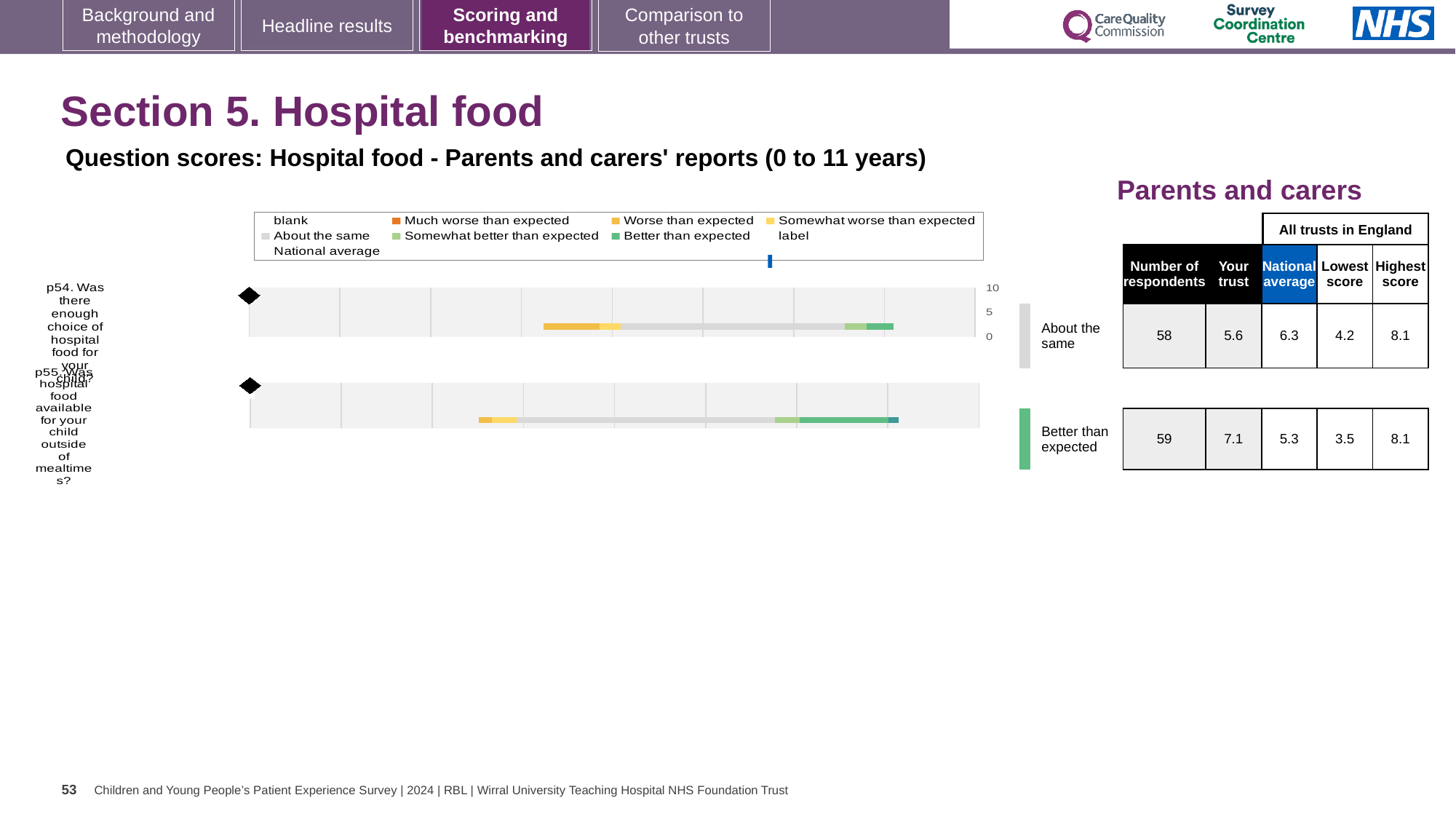
Which question has the higher 'Your trust' score, p54 or p55? p55 Which benchmark category is p54 (enough choice of hospital food) rated as? About the same Which benchmark category is p55 (hospital food available outside of mealtimes) rated as? Better than expected How many questions are plotted in the hospital food chart? 2 In the table, what is the highest score across all trusts in England for p54? 8.1 For p55, what is the difference between the 'Your trust' score and the national average? 1.8 In the table, what is the 'Your trust' score for p55 (hospital food available outside of mealtimes)? 7.1 In the table, what is the national average score for p54 (enough choice of hospital food)? 6.3 In the table, how many respondents answered p54 (enough choice of hospital food)? 58 What kind of chart is used to show the question scores for hospital food? bar chart For p54, which is larger: the 'Your trust' score or the national average? National average In the table, what is the lowest score across all trusts in England for p55? 3.5